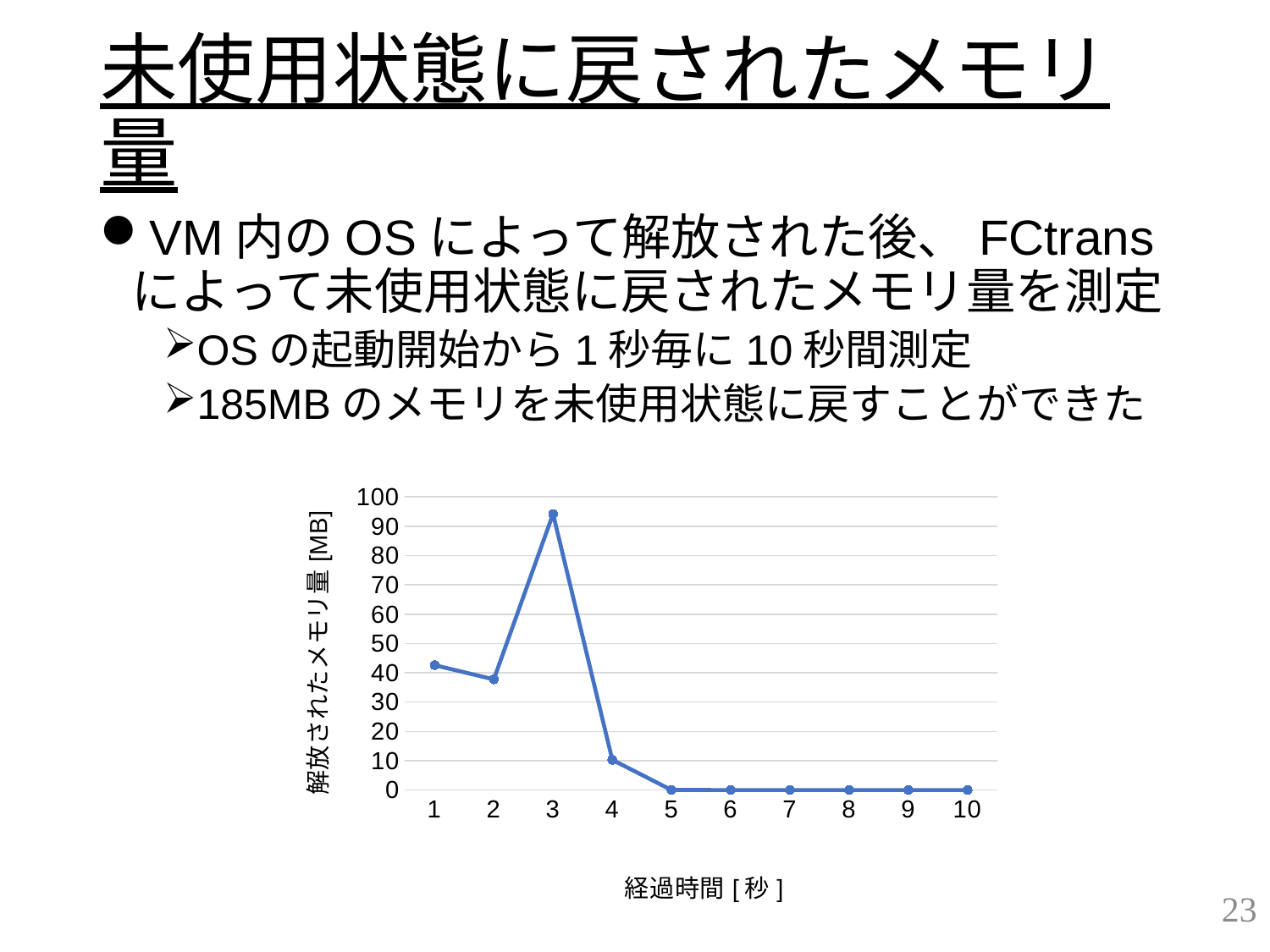
Which is larger, the value at 3 seconds or the value at 1 second? 3 seconds What is the released memory amount at 10 seconds? 0 What is the released memory amount at 5 seconds? 0 Do the values rise or fall from 3 seconds to 5 seconds? fall How many data points are plotted on the line chart? 10 Is the value at 2 seconds greater or less than 30? greater What is the label of the y axis? 解放されたメモリ量 [MB] Is the value at 3 seconds greater or less than 90? greater What kind of chart is shown on the slide? line chart At which elapsed time (seconds) is the released memory amount highest? 3 Is the value at 4 seconds greater or less than 20? less